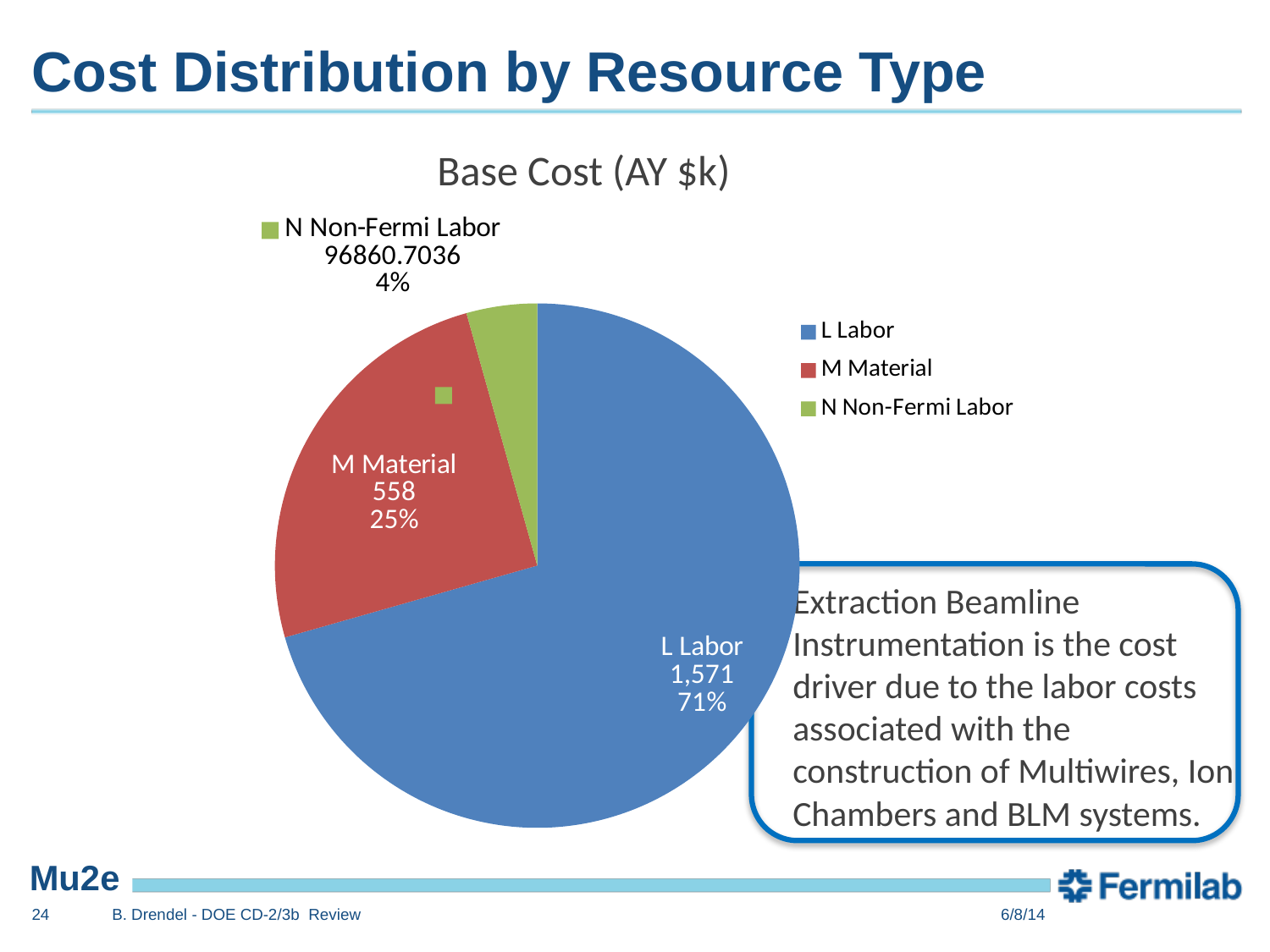
What share of the pie does M Material represent? 25% Which category has the largest slice of the pie? L Labor What is the value shown for L Labor? 1,571 How many entries does the legend list? 3 What is the value shown for M Material? 558 What share of the pie does N Non-Fermi Labor represent? 4% What share of the pie does L Labor represent? 71% What is the title of the chart? Base Cost (AY $k) What kind of chart is shown on the slide? pie chart What value is printed for N Non-Fermi Labor? 96860.7036 How many slices does the pie chart have? 3 Which category has the smallest slice of the pie? N Non-Fermi Labor